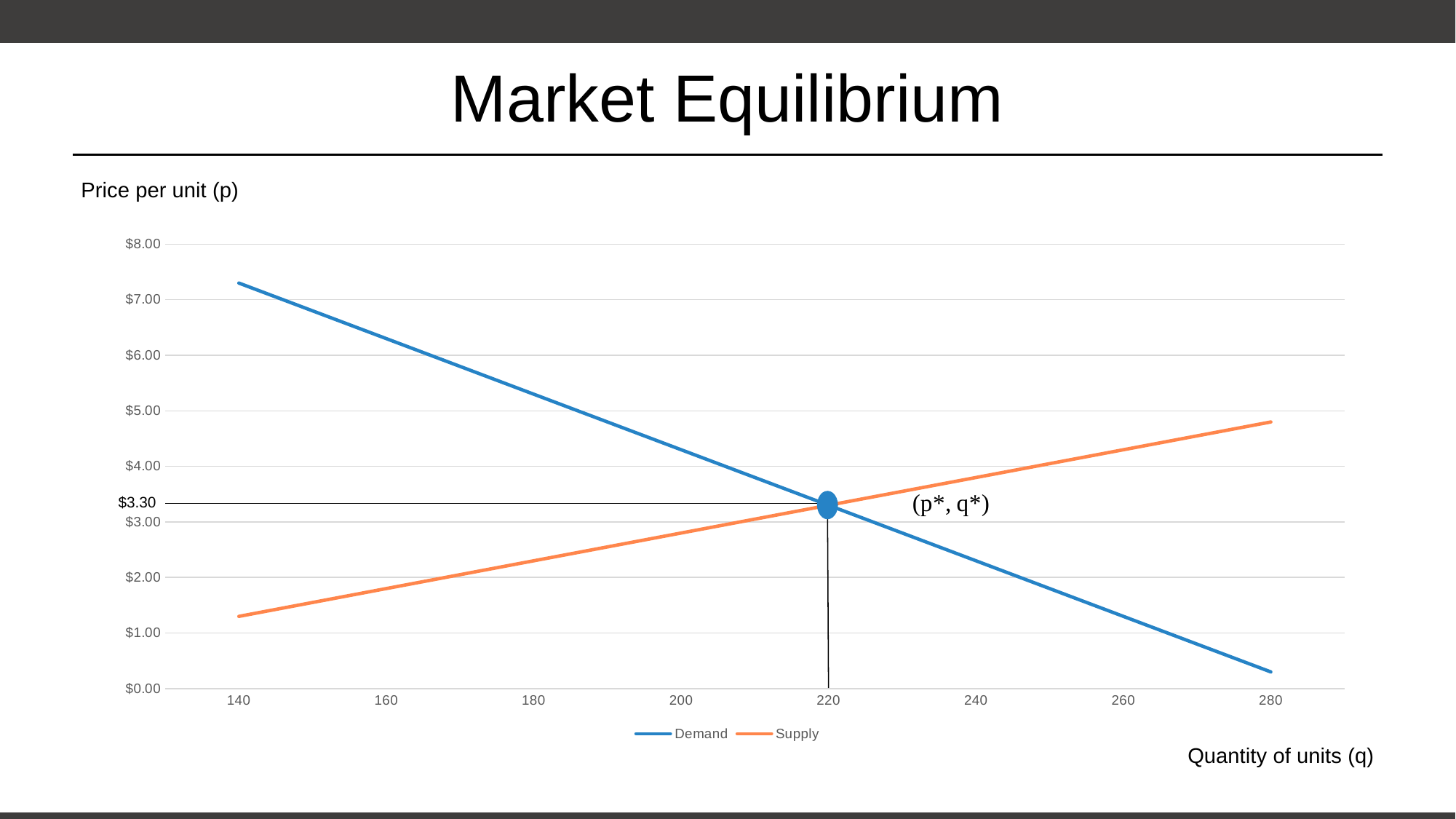
At quantity 160, which line is higher, Demand or Supply? Demand What is the label of the vertical axis? Price per unit (p) What are the two series named in the legend? Demand and Supply At quantity 260, which line is higher, Demand or Supply? Supply What price is marked at the point where the Demand and Supply lines intersect? $3.30 Does the Demand line rise or fall as quantity increases along the x axis? fall Is the Supply value at quantity 280 greater or less than $5.00? less Is the Demand value at quantity 140 greater or less than $7.00? greater How many series does the legend list? 2 What kind of chart is shown on the slide? line chart Does the Supply line rise or fall as quantity increases along the x axis? rise At what quantity do the Demand and Supply lines intersect? 220